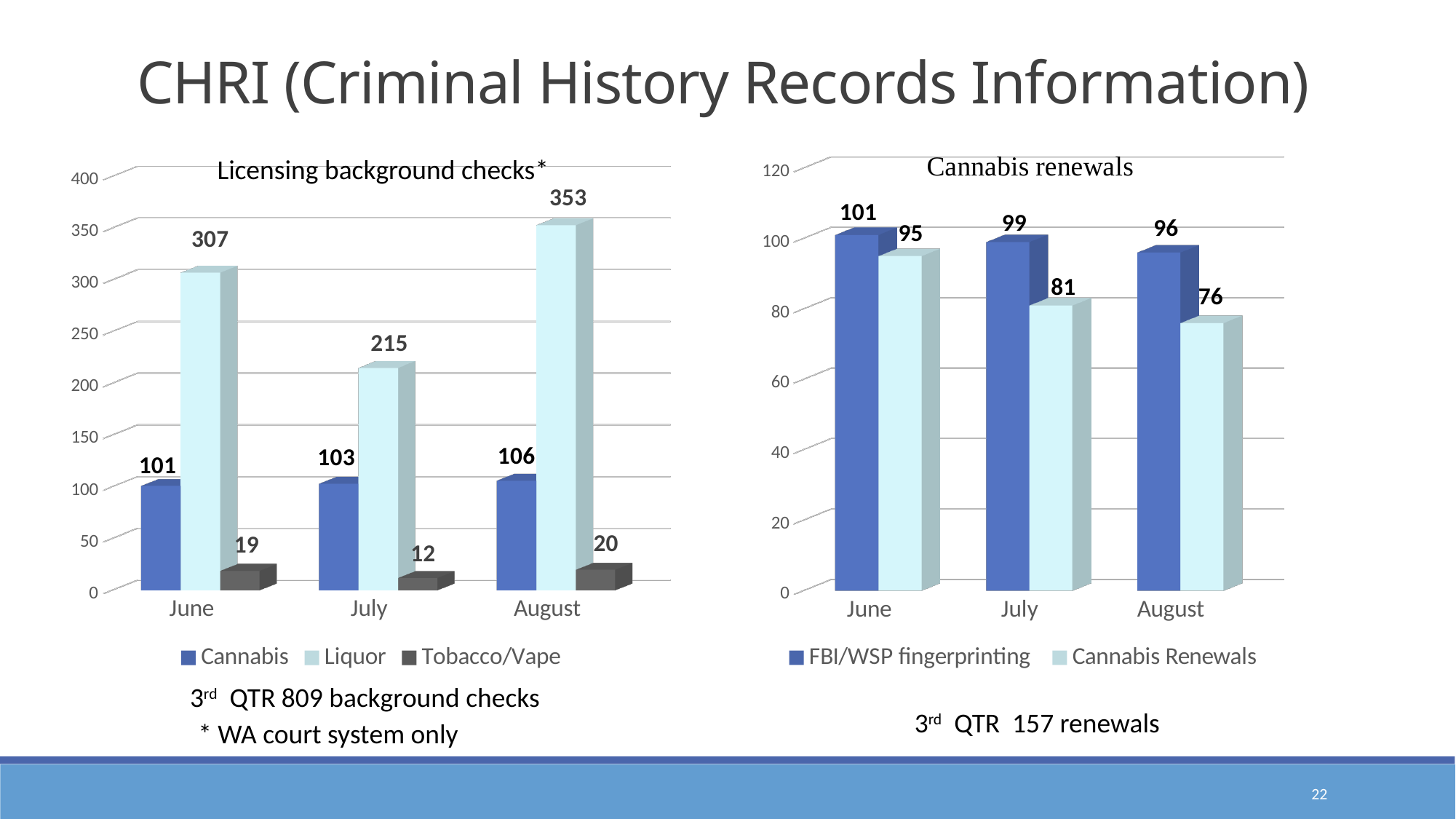
In the 'Licensing background checks*' chart, what is the value for Liquor in August? 353 What kind of chart is the 'Cannabis renewals' chart? bar chart In the 'Licensing background checks*' chart, what is the value for Tobacco/Vape in July? 12 In the 'Licensing background checks*' chart, what is the difference between the Liquor values for June and July? 92 In the 'Licensing background checks*' chart, is the Cannabis value for August greater or less than 100? greater In the 'Cannabis renewals' chart, which month has the lowest FBI/WSP fingerprinting value? August In the 'Cannabis renewals' chart, how many months are shown on the x axis? 3 In the 'Cannabis renewals' chart, which is larger in June: FBI/WSP fingerprinting or Cannabis Renewals? FBI/WSP fingerprinting In the 'Licensing background checks*' chart, how many series does the legend list? 3 In the 'Cannabis renewals' chart, do the Cannabis Renewals values rise or fall from June to August? fall In the 'Cannabis renewals' chart, what is the value for Cannabis Renewals in July? 81 In the 'Licensing background checks*' chart, which month has the highest Liquor value? August